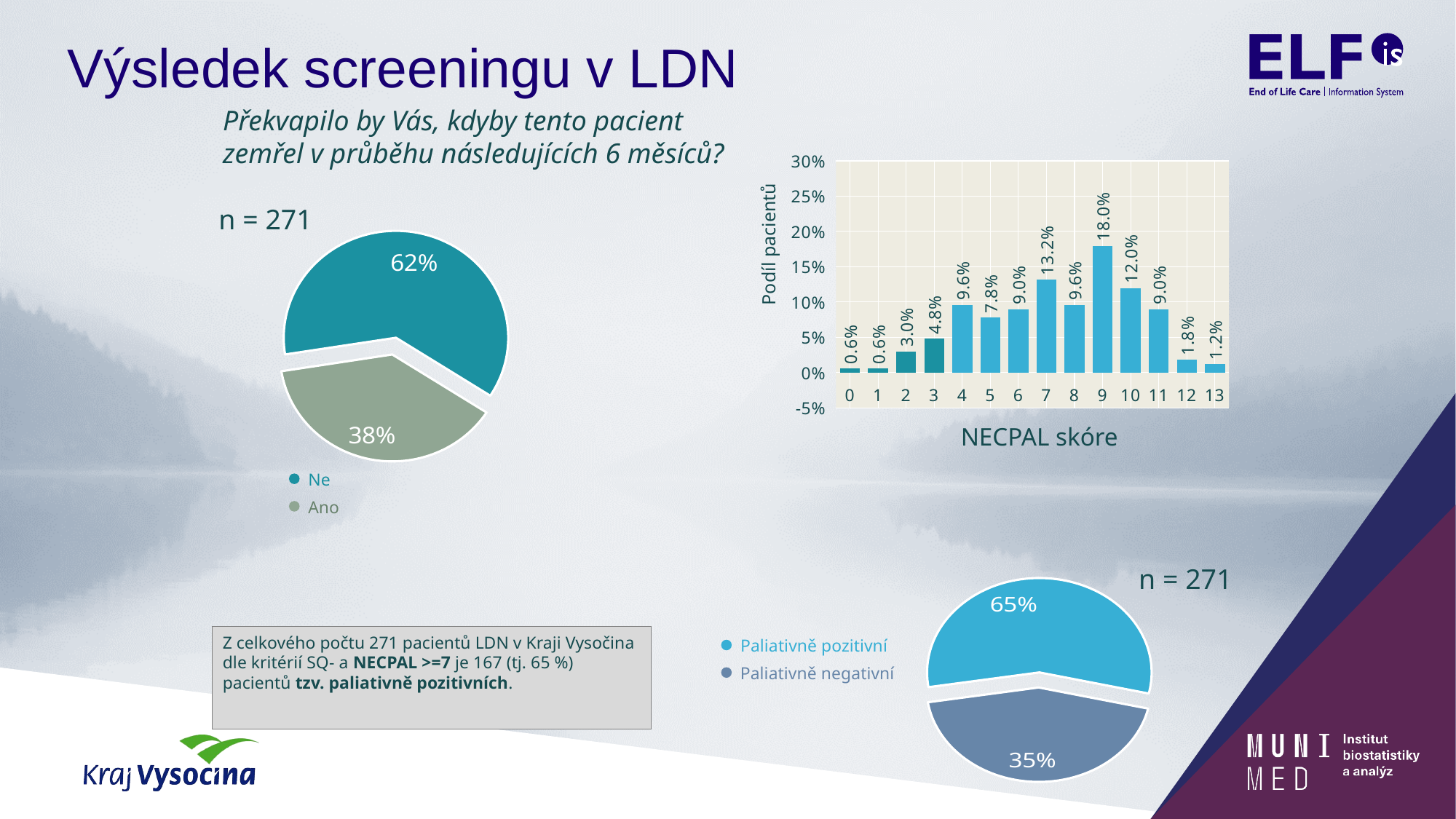
In the bar chart of NECPAL skóre, what is the value for score 7? 13.2% In the bar chart of NECPAL skóre, which score has the highest share of patients? 9 In the pie chart on the left of the slide, what share is labelled Ne? 62% In the bar chart of NECPAL skóre, what is the difference between the values for score 9 and score 10? 6.0% How many NECPAL score categories are shown on the x axis of the bar chart? 14 In the pie chart on the left of the slide, which slice is larger: Ne or Ano? Ne In the pie chart at the bottom right of the slide, what is the difference between the Paliativně pozitivní and Paliativně negativní shares? 30% What is the y axis label of the bar chart? Podíl pacientů In the bar chart of NECPAL skóre, what is the value for score 9? 18.0% In the pie chart at the bottom right of the slide, what share is Paliativně negativní? 35% What kind of chart is the chart with the x axis labelled NECPAL skóre? bar chart In the bar chart of NECPAL skóre, which is larger: the value for score 4 or the value for score 5? score 4